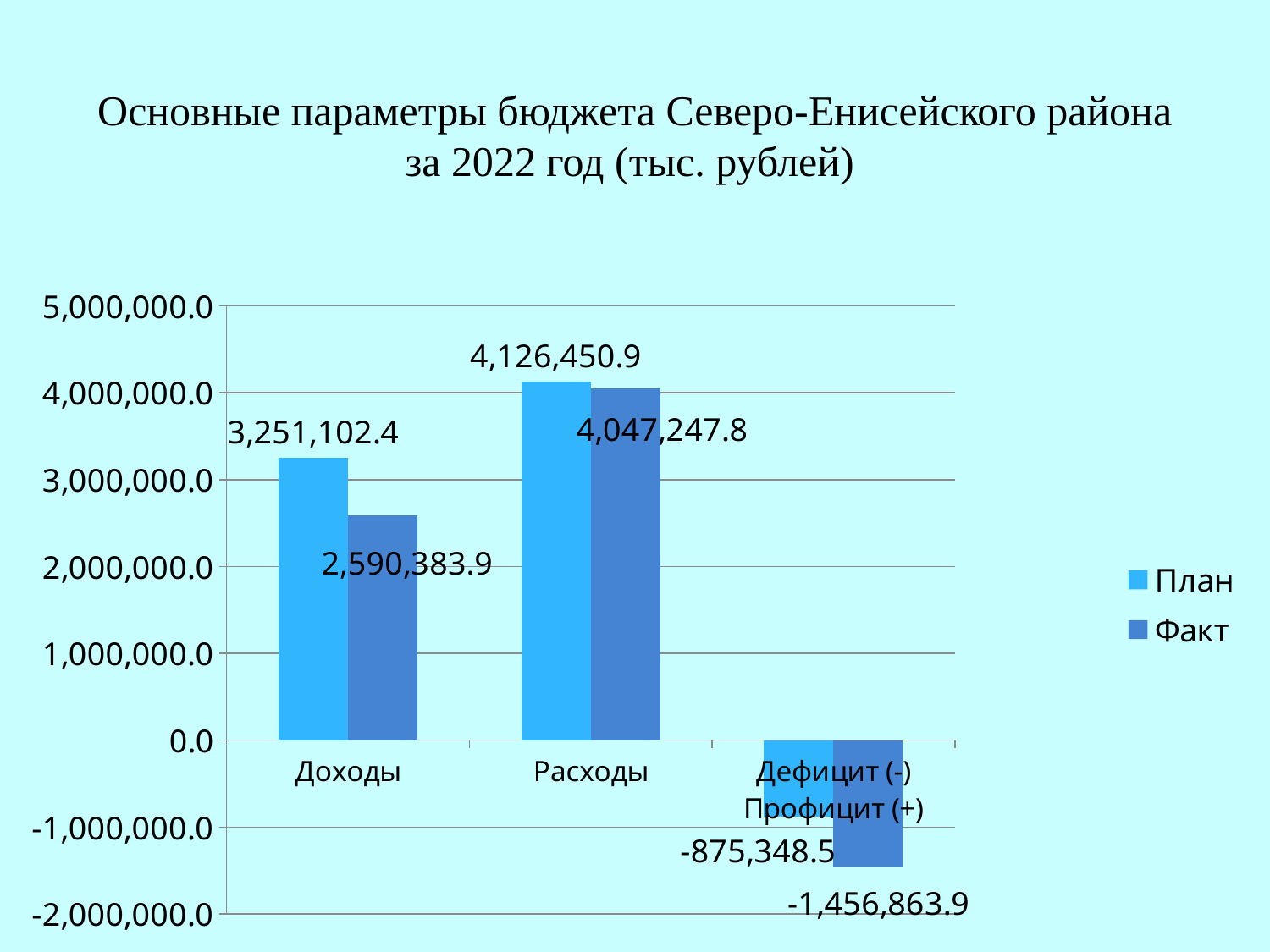
What is the План value for Дефицит (-) Профицит (+)? -875,348.5 Which category has the lowest Факт value? Дефицит (-) Профицит (+) What is the Факт value for Расходы? 4,047,247.8 Which category has the highest План value? Расходы What is the План value for Доходы? 3,251,102.4 What is the Факт value for Дефицит (-) Профицит (+)? -1,456,863.9 How many series does the legend list? 2 How many categories are shown on the x axis? 3 What kind of chart is shown on the slide? Bar chart Which is larger for Доходы, the План value or the Факт value? План What is the difference between the План and Факт values for Расходы? 79,203.1 What is the difference between the План and Факт values for Доходы? 660,718.5